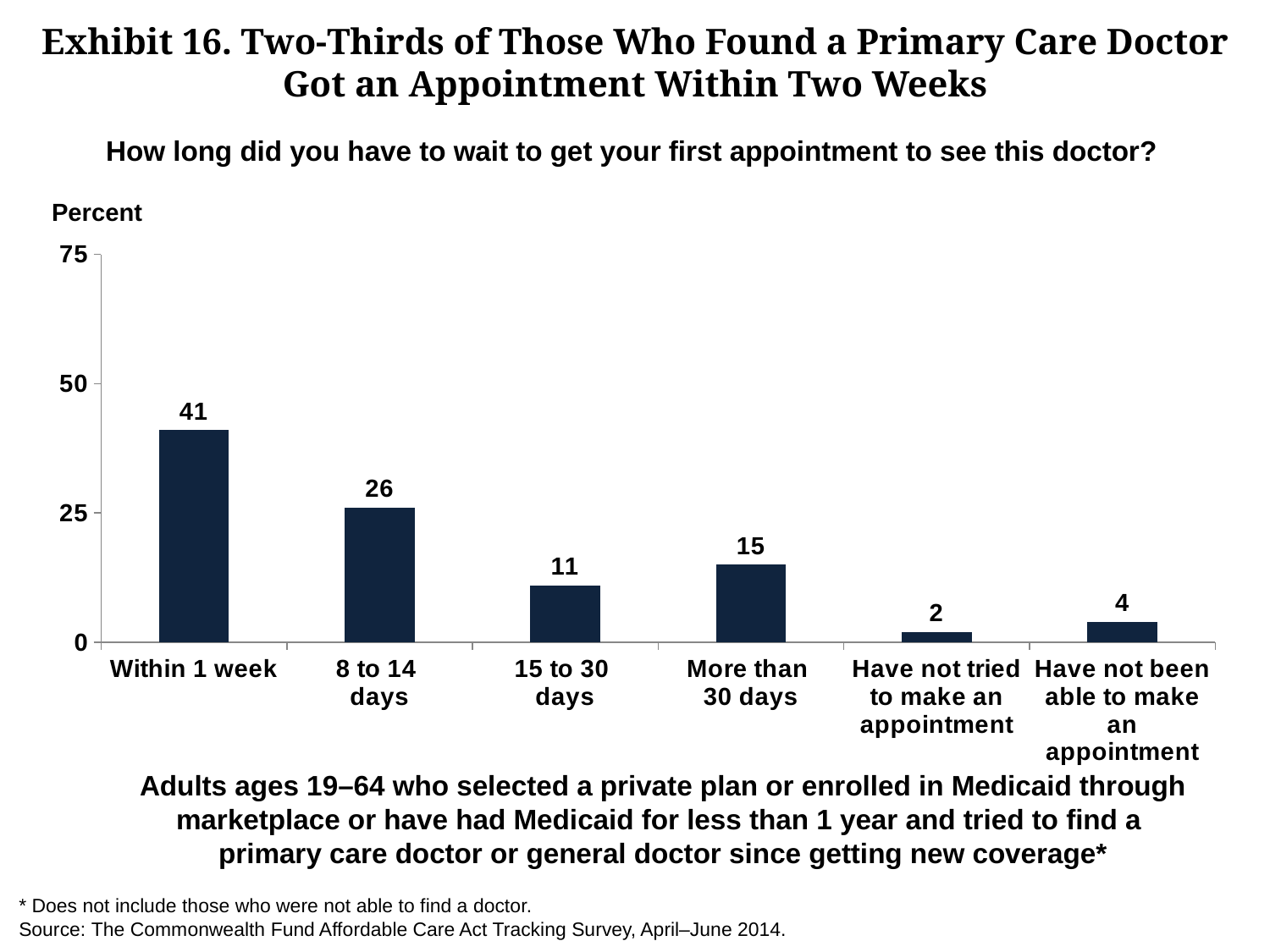
Which is larger, the value for '15 to 30 days' or 'More than 30 days'? More than 30 days What kind of chart is shown on the slide? Bar chart Which category has the highest value? Within 1 week What is the value for 'More than 30 days'? 15 Is the value for 'Within 1 week' greater or less than 50? less What is the value for '8 to 14 days'? 26 What percent of respondents got their first appointment within 1 week? 41 What is the difference between the values for 'Within 1 week' and '8 to 14 days'? 15 How many categories are shown on the x axis? 6 Which category has the lowest value? Have not tried to make an appointment What is the label on the vertical axis? Percent What is the value for 'Have not been able to make an appointment'? 4